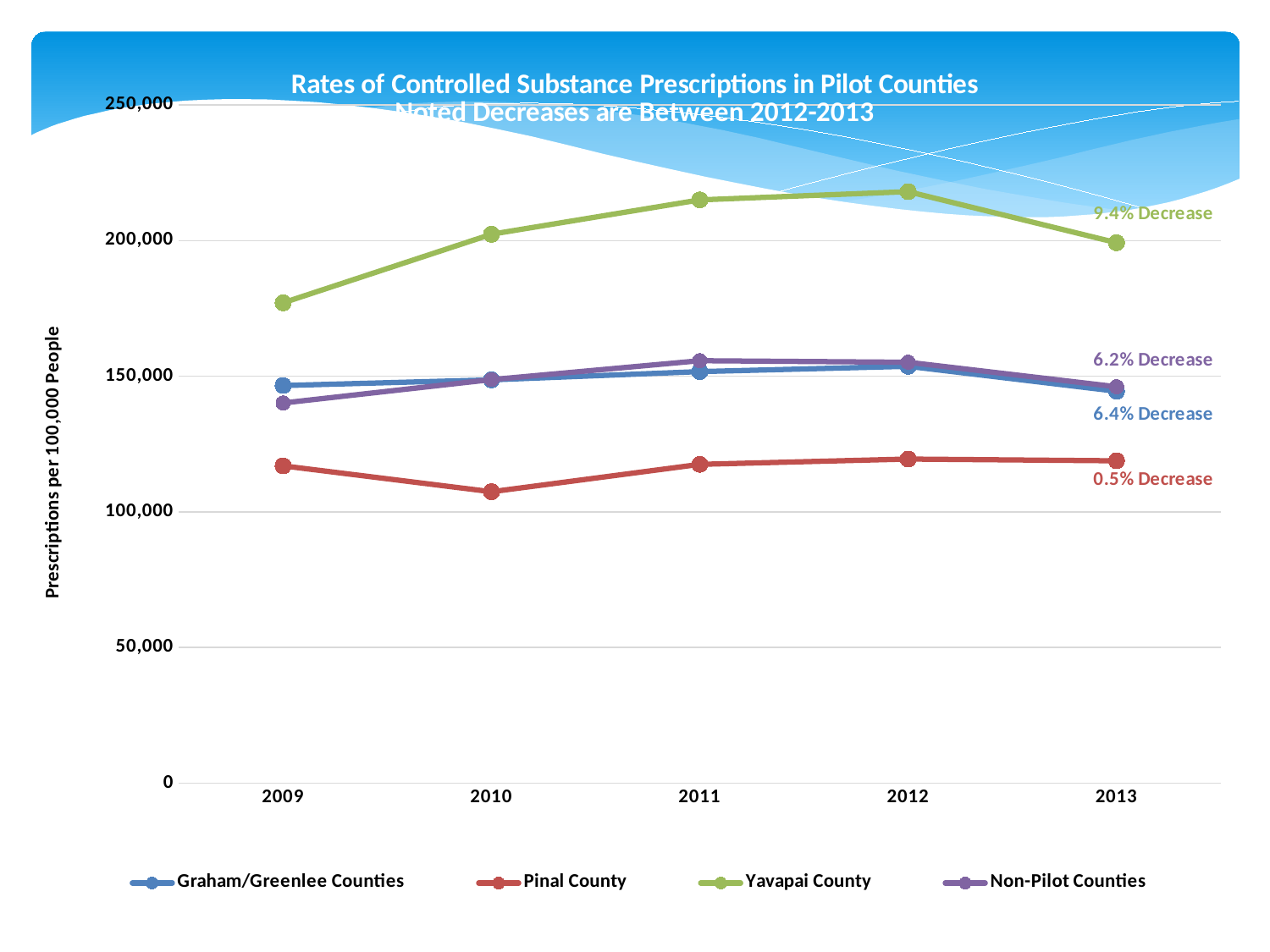
How many years are plotted along the x axis? 5 Which is larger in 2011, the value for Yavapai County or the value for Pinal County? Yavapai County What percentage decrease is noted for Yavapai County between 2012 and 2013? 9.4% Decrease What kind of chart is shown on the slide? Line chart Is the value for Yavapai County in 2012 greater or less than 200,000? greater Which series has the highest prescription rate in 2012? Yavapai County How many series does the legend list? 4 Which series has the lowest prescription rate in 2009? Pinal County What percentage decrease is noted for Pinal County between 2012 and 2013? 0.5% Decrease Is the value for Non-Pilot Counties in 2009 greater or less than 150,000? less Is the value for Pinal County in 2010 greater or less than 100,000? greater Does the Yavapai County line rise or fall from 2009 to 2012? rise